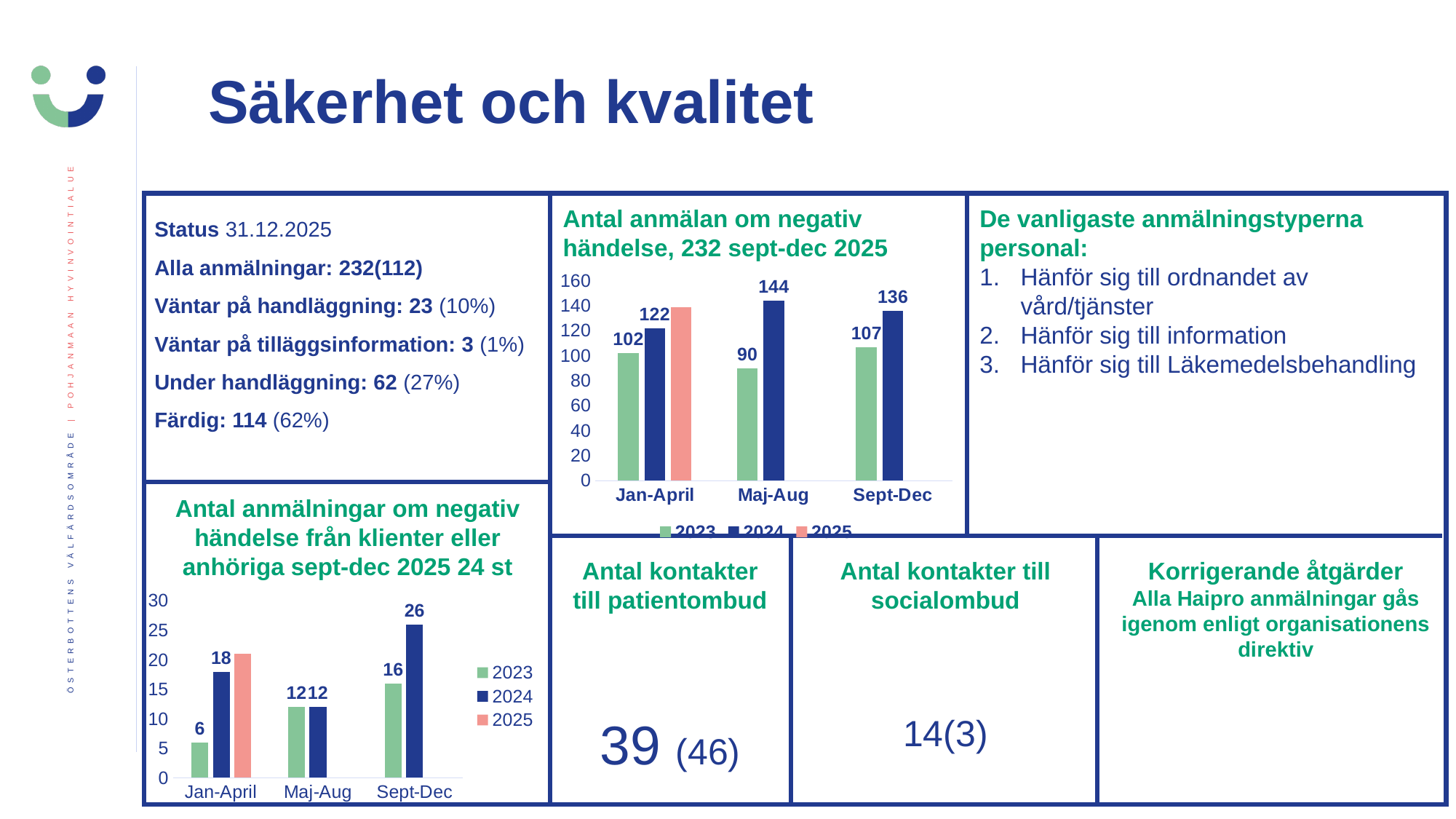
In the chart titled 'Antal anmälan om negativ händelse, 232 sept-dec 2025', which period has the lowest value for 2023? Maj-Aug In the chart titled 'Antal anmälan om negativ händelse, 232 sept-dec 2025', what is the value for 2023 in Jan-April? 102 In the chart titled 'Antal anmälan om negativ händelse, 232 sept-dec 2025', what is the value for 2024 in Maj-Aug? 144 What kind of chart is the one titled 'Antal anmälningar om negativ händelse från klienter eller anhöriga sept-dec 2025 24 st'? bar chart In the chart titled 'Antal anmälningar om negativ händelse från klienter eller anhöriga sept-dec 2025 24 st', how many periods are shown on the x axis? 3 In the chart titled 'Antal anmälningar om negativ händelse från klienter eller anhöriga sept-dec 2025 24 st', what is the value for 2023 in Jan-April? 6 In the chart titled 'Antal anmälan om negativ händelse, 232 sept-dec 2025', is the 2025 value for Jan-April greater or less than 120? greater In the chart titled 'Antal anmälan om negativ händelse, 232 sept-dec 2025', how many series does the legend list? 3 In the chart titled 'Antal anmälningar om negativ händelse från klienter eller anhöriga sept-dec 2025 24 st', what is the value for 2024 in Sept-Dec? 26 In the chart titled 'Antal anmälningar om negativ händelse från klienter eller anhöriga sept-dec 2025 24 st', which is larger in Jan-April: the 2023 value or the 2024 value? 2024 In the chart titled 'Antal anmälan om negativ händelse, 232 sept-dec 2025', what is the difference between the 2024 and 2023 values in Sept-Dec? 29